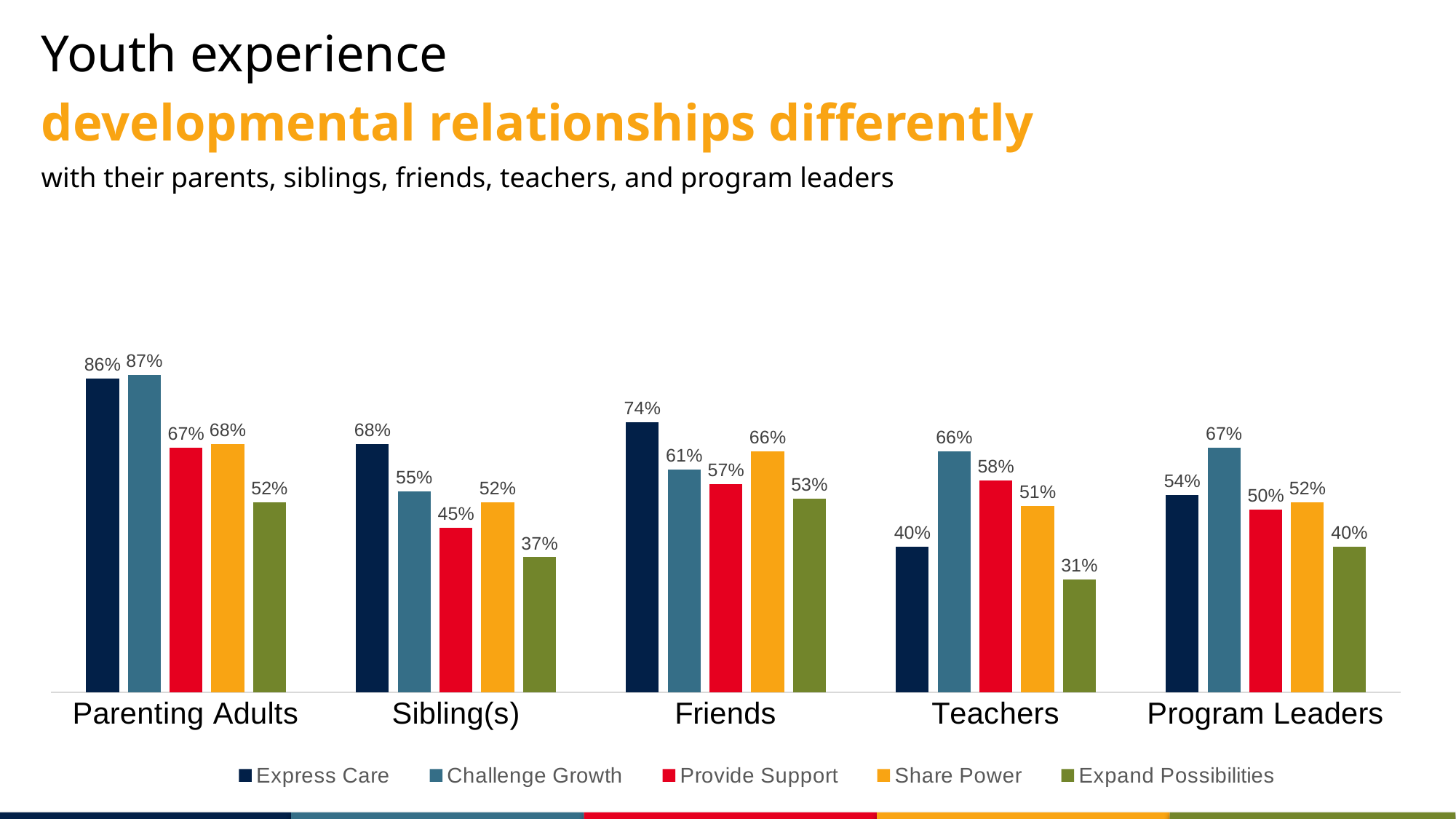
What is the Provide Support value for Program Leaders? 50% What is the difference between the Challenge Growth values for Parenting Adults and Sibling(s)? 32% How many categories are shown on the x axis? 5 Which series is shown in red in the legend? Provide Support How many series does the legend list? 5 What is the Share Power value for Friends? 66% Which category has the highest Express Care value? Parenting Adults What is the Expand Possibilities value for Teachers? 31% What kind of chart is shown on the slide? Bar chart Which is larger for Teachers: Express Care or Challenge Growth? Challenge Growth Which category has the lowest Expand Possibilities value? Teachers What is the Express Care value for Parenting Adults? 86%